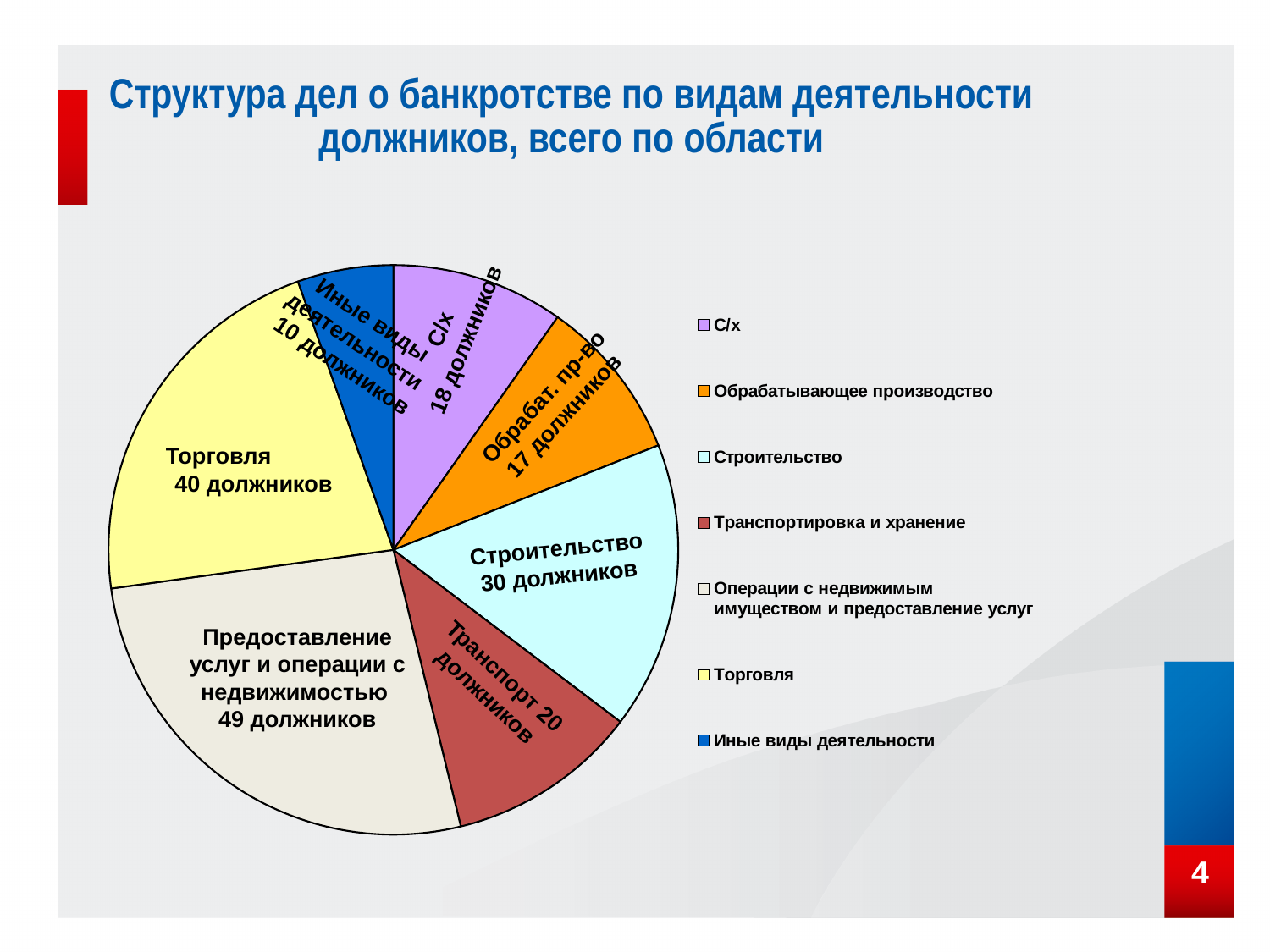
Which has more debtors, С/х or Обрабат. пр-во? С/х What is the difference in debtors between Торговля and Строительство? 10 How many slices does the pie chart have? 7 What kind of chart is shown on the slide? pie chart What is the total number of debtors across all slices of the pie chart? 184 How many debtors are in the Транспорт slice? 20 должников How many debtors are in the Строительство slice? 30 должников Which category has the largest number of debtors? Предоставление услуг и операции с недвижимостью What is the title of the slide? Структура дел о банкротстве по видам деятельности должников, всего по области Which category has the smallest number of debtors? Иные виды деятельности How many debtors are in the Торговля slice? 40 должников How many debtors are in the С/х slice? 18 должников